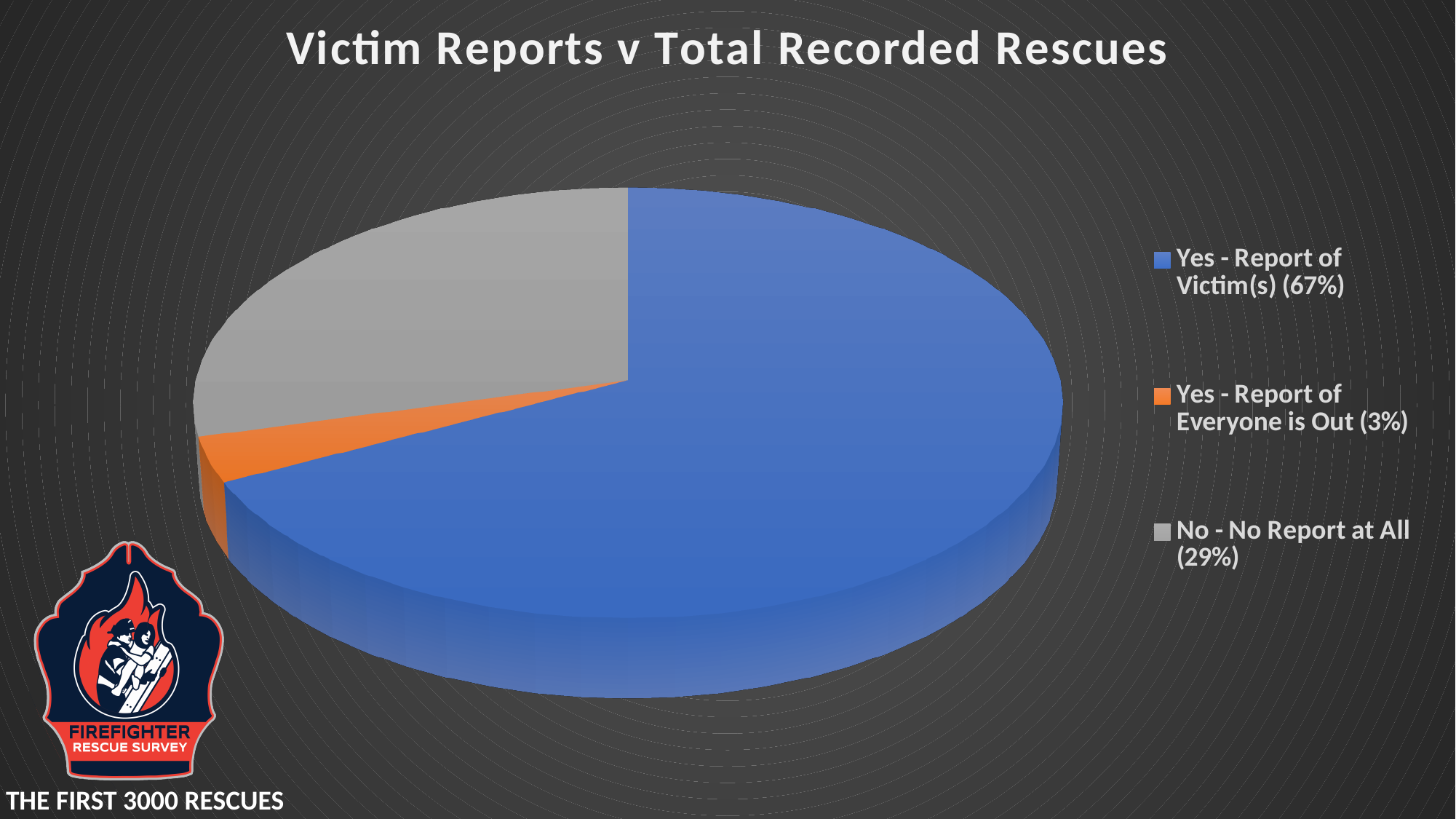
What share of the pie is 'No - No Report at All'? 29% Which category has the smallest slice of the pie? Yes - Report of Everyone is Out What is the combined share of the two 'Yes' categories? 70% What share of the pie is 'Yes - Report of Victim(s)'? 67% What is the title of the chart? Victim Reports v Total Recorded Rescues What share of the pie is 'Yes - Report of Everyone is Out'? 3% What colour is the slice for 'No - No Report at All'? Grey Which category has the largest slice of the pie? Yes - Report of Victim(s) What kind of chart is shown on the slide? Pie chart How many categories does the pie chart show? 3 Which is larger: 'No - No Report at All' or 'Yes - Report of Everyone is Out'? No - No Report at All What is the difference in percentage points between 'Yes - Report of Victim(s)' and 'No - No Report at All'? 38